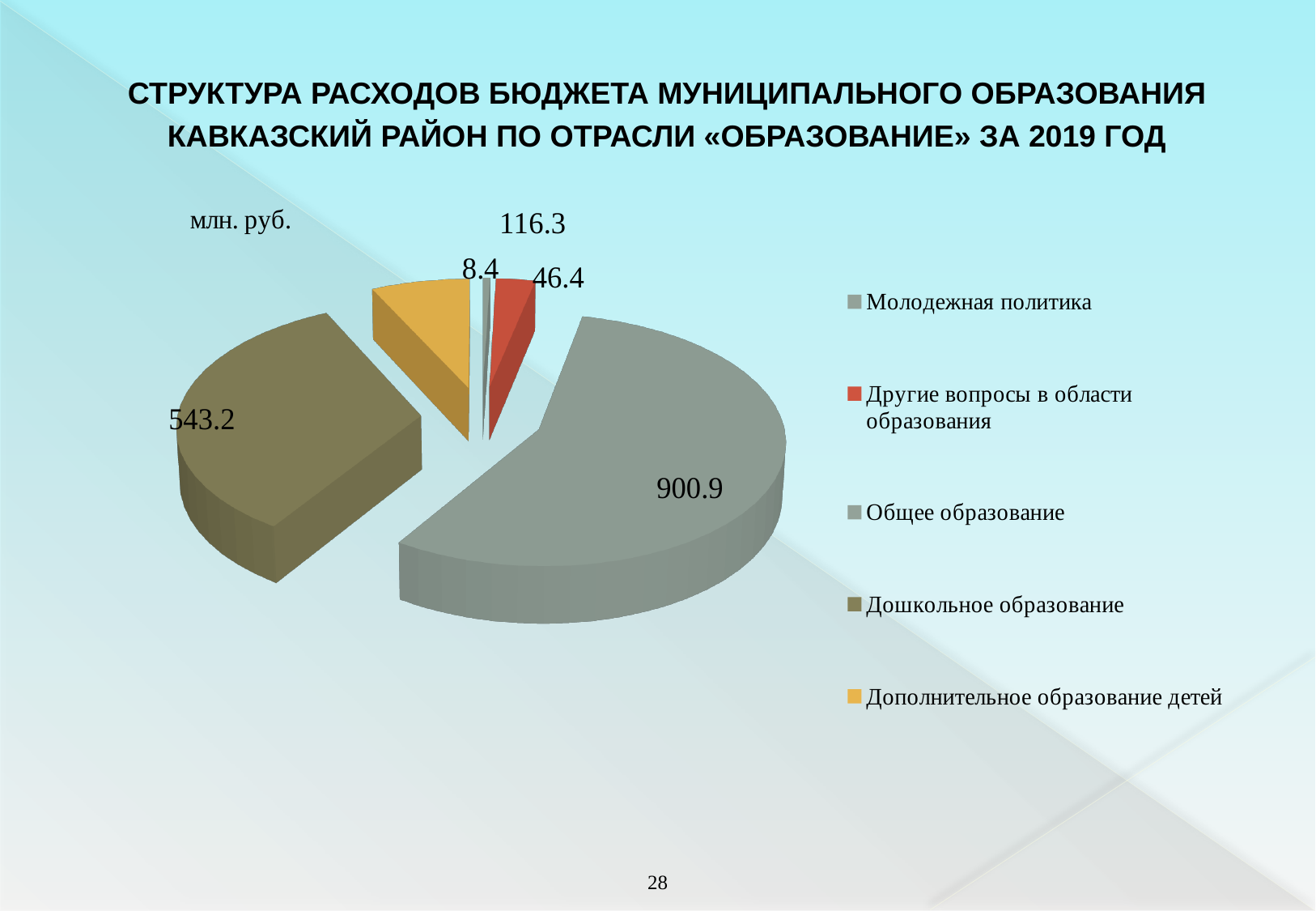
What is the value for Молодежная политика? 8.4 Which category has the smallest slice of the pie? Молодежная политика Which category has the largest slice of the pie? Общее образование Which is larger, the value for Дополнительное образование детей or the value for Другие вопросы в области образования? Дополнительное образование детей What is the value for Дошкольное образование? 543.2 What is the value for Дополнительное образование детей? 116.3 What kind of chart is shown on the slide? pie chart What is the value for Другие вопросы в области образования? 46.4 What is the difference between the values for Общее образование and Дошкольное образование? 357.7 In what units are the values on the chart given? млн. руб. How many categories does the legend list? 5 What is the value for Общее образование? 900.9